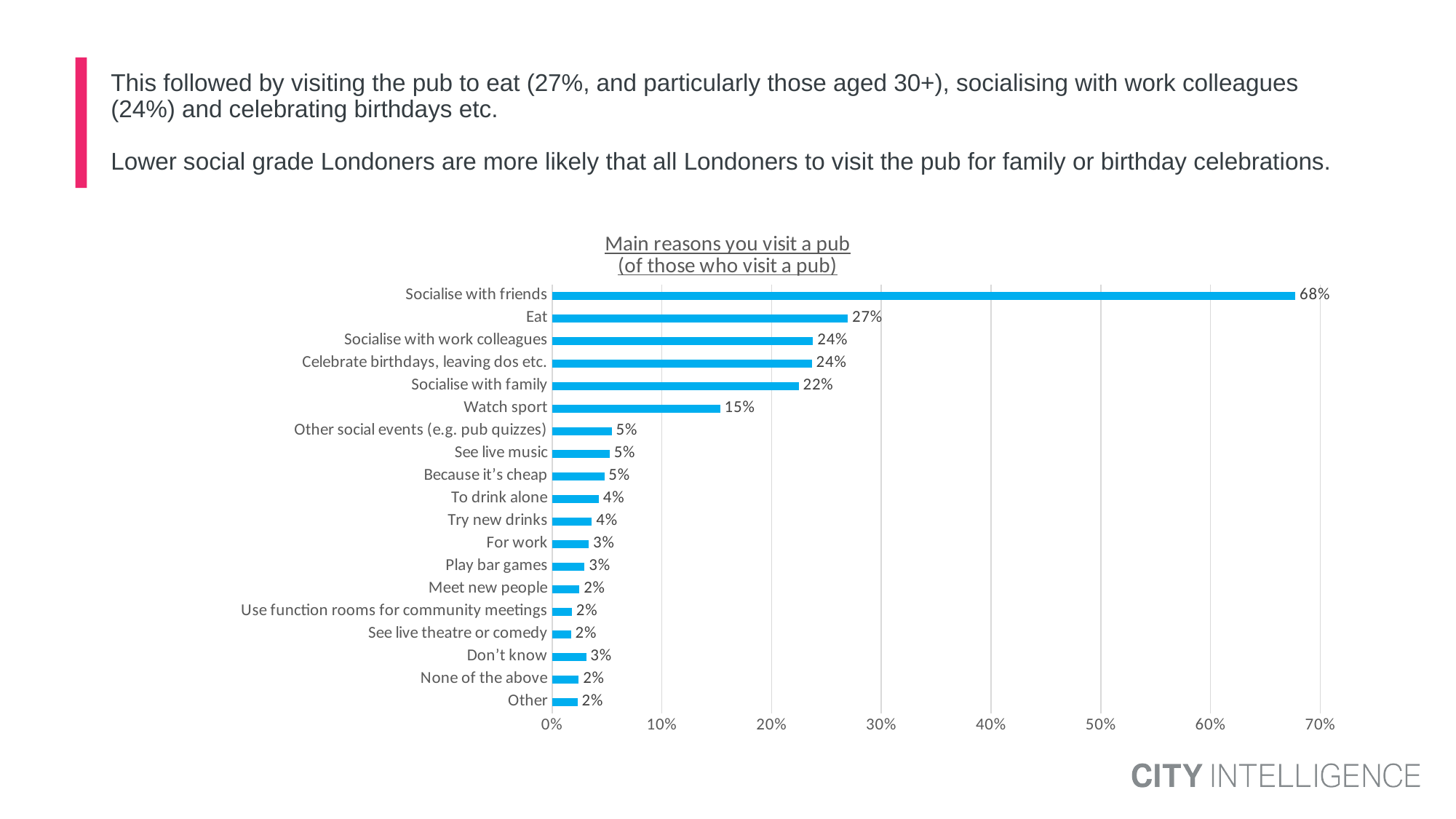
What is the title of the chart? Main reasons you visit a pub (of those who visit a pub) How many categories are shown in the chart? 19 What is the difference between the values for 'Socialise with family' and 'Watch sport'? 7% What percentage of pub visitors say they visit to socialise with friends? 68% Which is larger, the value for 'Watch sport' or the value for 'See live music'? Watch sport Is the value for 'Socialise with friends' greater or less than 60%? greater Which is larger, the value for 'Eat' or the value for 'Socialise with work colleagues'? Eat What is the value for 'Socialise with family'? 22% What kind of chart is shown on the slide? Bar chart Which reason for visiting a pub has the highest value? Socialise with friends What is the value for 'Watch sport'? 15% What is the difference between the values for 'Socialise with friends' and 'Eat'? 41%